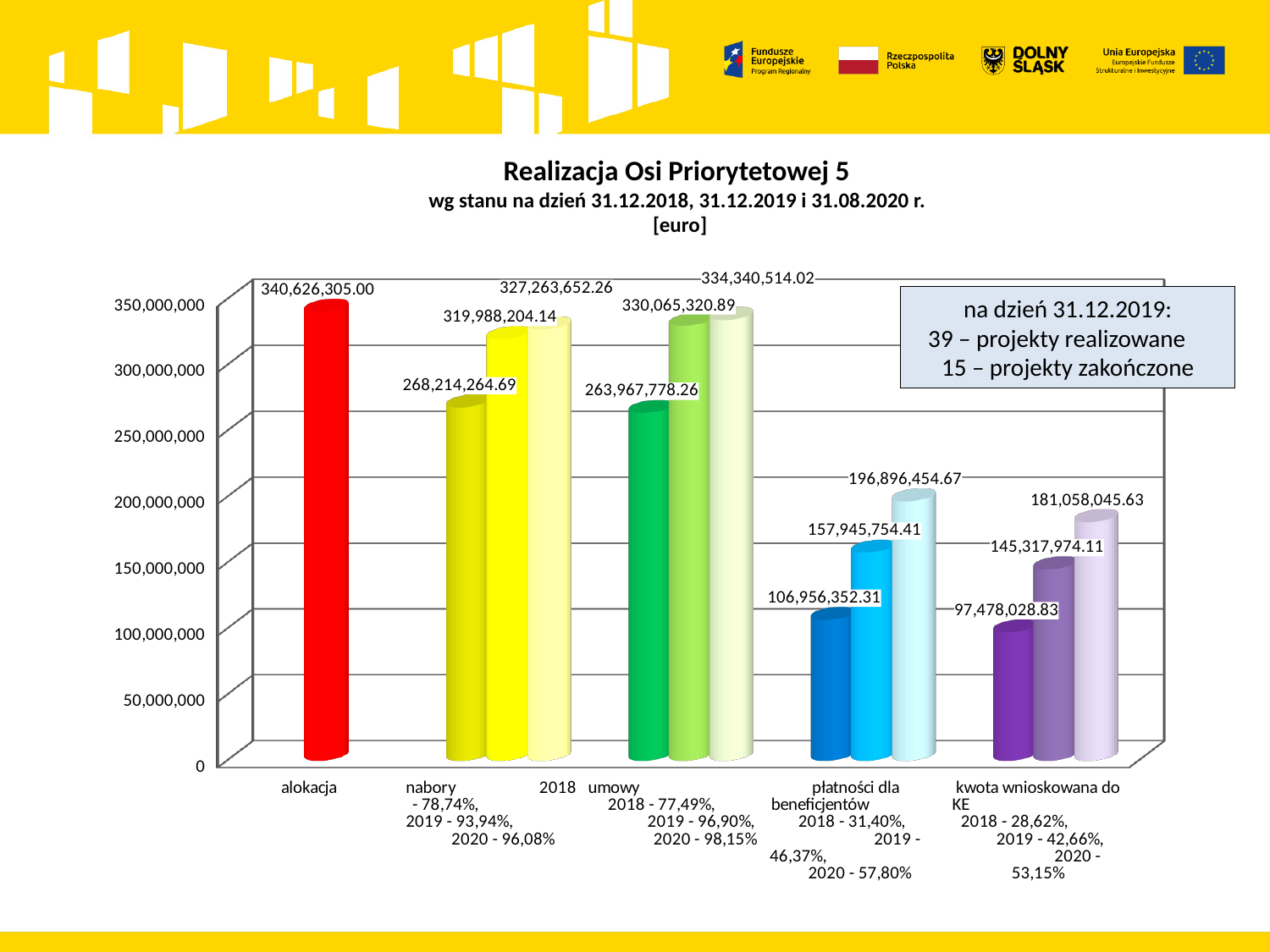
What is the 2019 value for kwota wnioskowana do KE? 145,317,974.11 Which is larger: the 2019 value for nabory or the 2019 value for umowy? umowy (330,065,320.89) What is the difference between the 2020 value for umowy and the 2020 value for nabory? 7,076,861.76 What is the 2020 value for umowy? 334,340,514.02 What is the 2018 value for płatności dla beneficjentów? 106,956,352.31 Which bar on the chart has the lowest value? kwota wnioskowana do KE, 2018 (97,478,028.83) Do the values for płatności dla beneficjentów rise or fall from 2018 to 2020? rise How many categories are shown on the x axis? 5 What is the value of the alokacja bar? 340,626,305.00 What kind of chart is shown on the slide? bar chart Is the 2018 value for kwota wnioskowana do KE greater or less than 100,000,000? less Which bar on the chart has the highest value? alokacja (340,626,305.00)